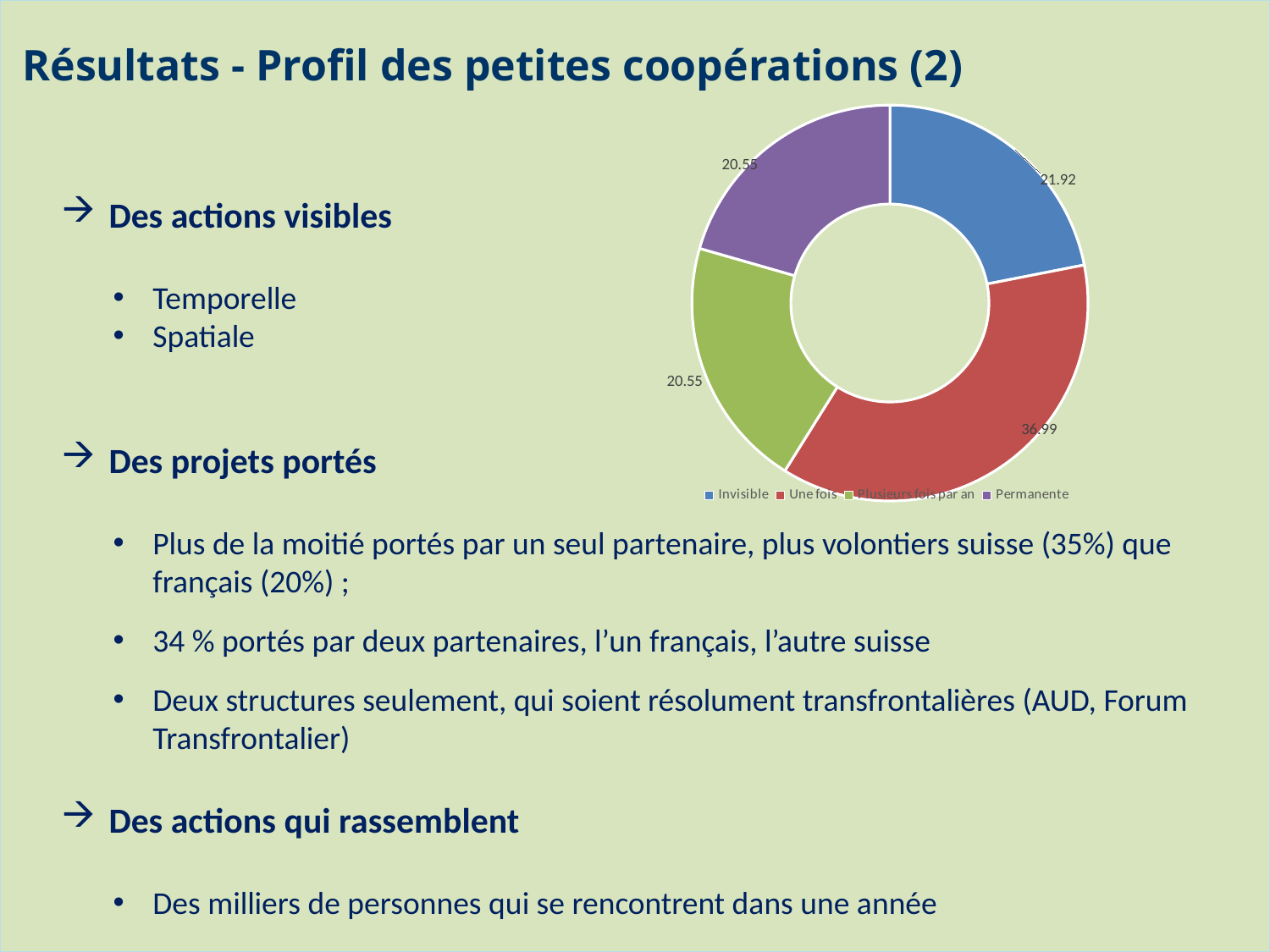
How many entries does the legend of the doughnut chart list? 4 What is the difference between the 'Une fois' and 'Invisible' values in the doughnut chart? 15.07 What is the value for the 'Invisible' segment in the doughnut chart? 21.92 What kind of chart is shown on the slide? Doughnut chart How many segments does the doughnut chart have? 4 What is the value for the 'Permanente' segment in the doughnut chart? 20.55 Which category has the largest segment in the doughnut chart? Une fois Which is larger in the doughnut chart, 'Invisible' or 'Une fois'? Une fois Which colour represents 'Une fois' in the doughnut chart? Red What is the value for the 'Plusieurs fois par an' segment in the doughnut chart? 20.55 What is the value for the 'Une fois' segment in the doughnut chart? 36.99 What is the difference between the 'Une fois' and 'Permanente' values in the doughnut chart? 16.44